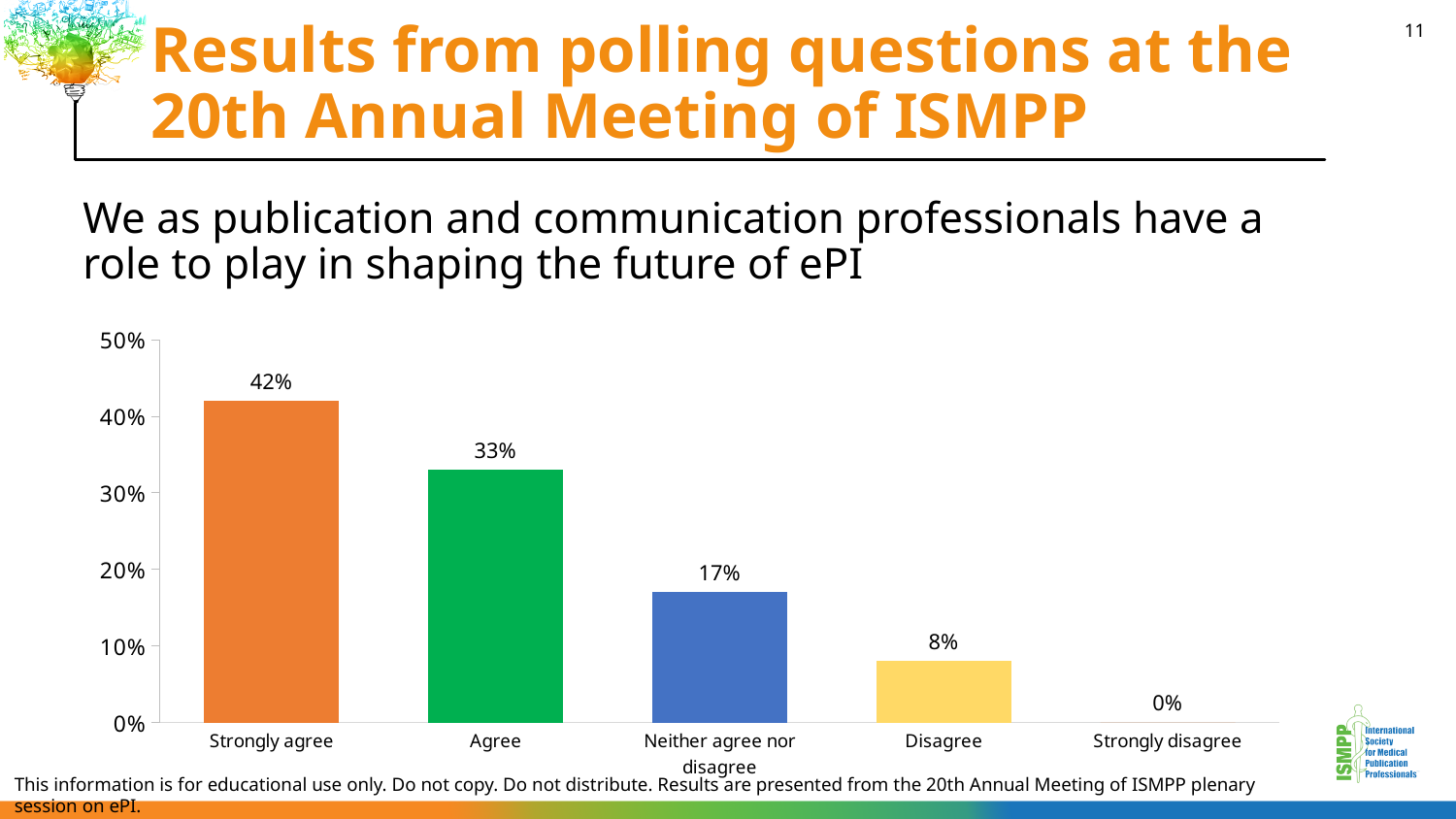
What is the difference in percentage points between "Strongly agree" and "Agree"? 9 percentage points Do the values rise or fall moving from left to right along the x axis? Fall Which response category has the lowest percentage? Strongly disagree What percentage of respondents chose "Agree"? 33% What percentage of respondents chose "Disagree"? 8% What type of chart is shown on the slide? Bar chart What percentage of respondents chose "Strongly agree"? 42% Which is larger, the percentage for "Neither agree nor disagree" or for "Disagree"? Neither agree nor disagree How many response categories are shown on the x axis? 5 What percentage of respondents chose "Neither agree nor disagree"? 17% Which response category has the highest percentage? Strongly agree What percentage of respondents chose "Strongly disagree"? 0%